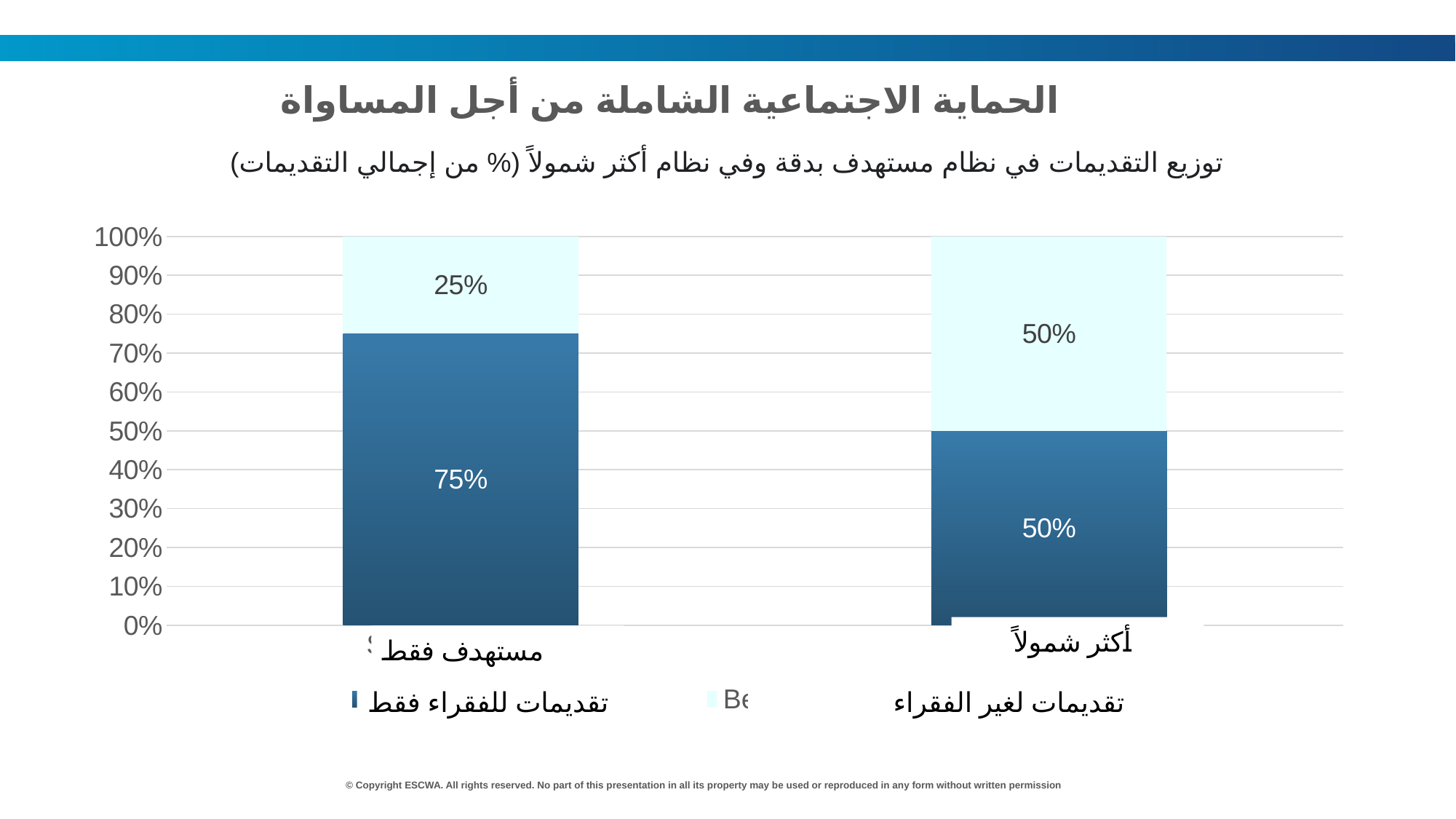
What is the total of the stacked bar for أكثر شمولاً? 100% How many series does the legend list? 2 Which category has the lower value for تقديمات لغير الفقراء? مستهدف فقط What is the difference between the تقديمات للفقراء فقط values for مستهدف فقط and أكثر شمولاً? 25% How many categories are shown on the x axis? 2 What is the value for تقديمات للفقراء فقط in the مستهدف فقط bar? 75% In the مستهدف فقط bar, which is larger: تقديمات للفقراء فقط or تقديمات لغير الفقراء? تقديمات للفقراء فقط What is the value for تقديمات لغير الفقراء in the مستهدف فقط bar? 25% What is the value for تقديمات للفقراء فقط in the أكثر شمولاً bar? 50% What is the value for تقديمات لغير الفقراء in the أكثر شمولاً bar? 50% What kind of chart is shown on the slide? Stacked bar chart Which category has the higher value for تقديمات للفقراء فقط? مستهدف فقط